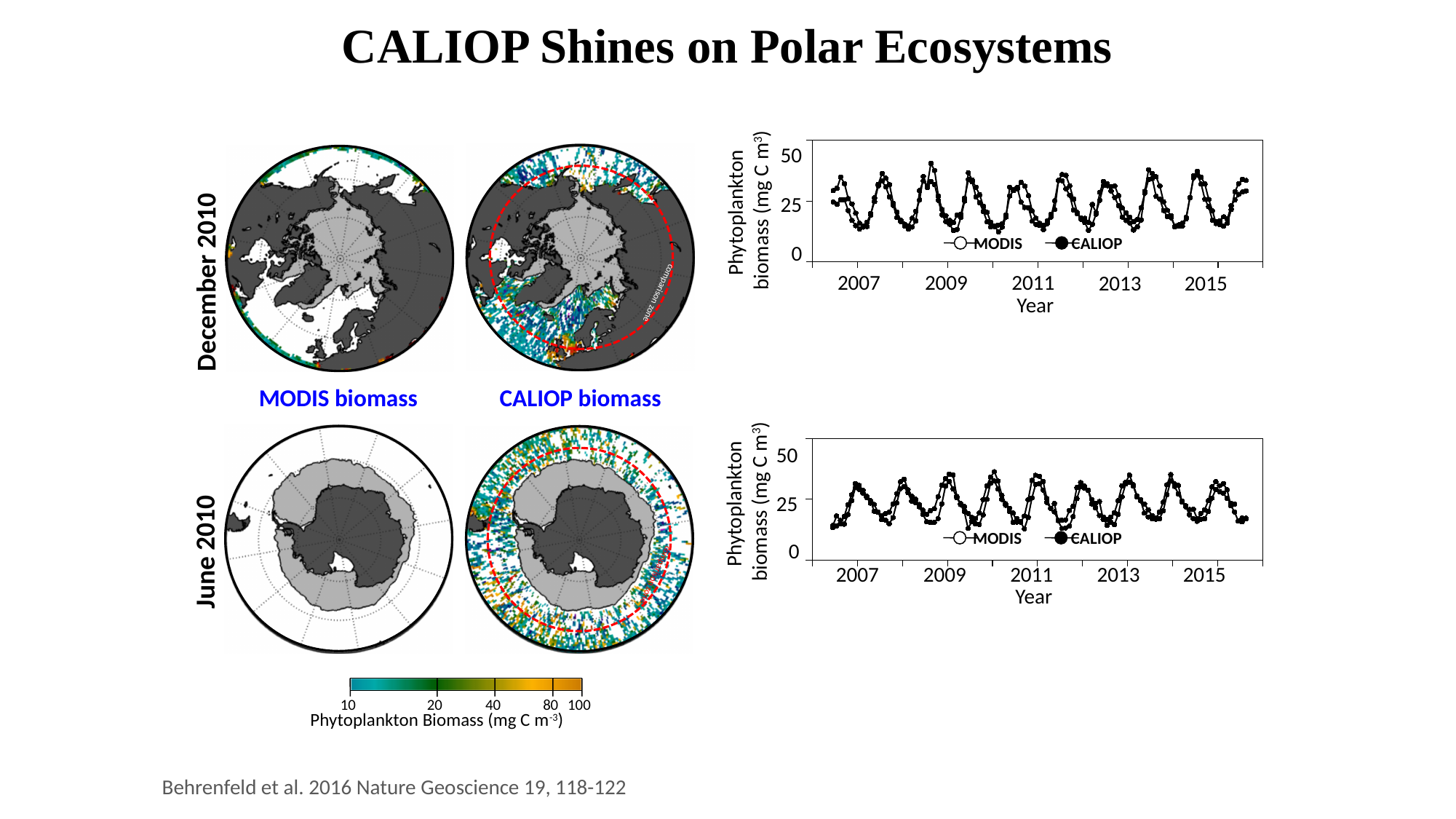
What is the y-axis label of the top right chart? Phytoplankton biomass (mg C m³) In the bottom right chart, is the highest peak greater or less than 50? less How many year tick labels are shown on the x axis of the top right chart? 5 In the top right chart, is the highest peak of the series greater or less than 50? less What is the last year label on the x axis of the top right chart? 2015 In the top right chart, do the values rise steadily, fall steadily, or oscillate along the x axis? oscillate What kind of chart is the top right chart? line chart In the top right chart, are the seasonal peaks greater or less than 25? greater How many series does the legend of the top right chart list? 2 What are the two series named in the legend of the bottom right chart? MODIS and CALIOP What is the first year label on the x axis of the bottom right chart? 2007